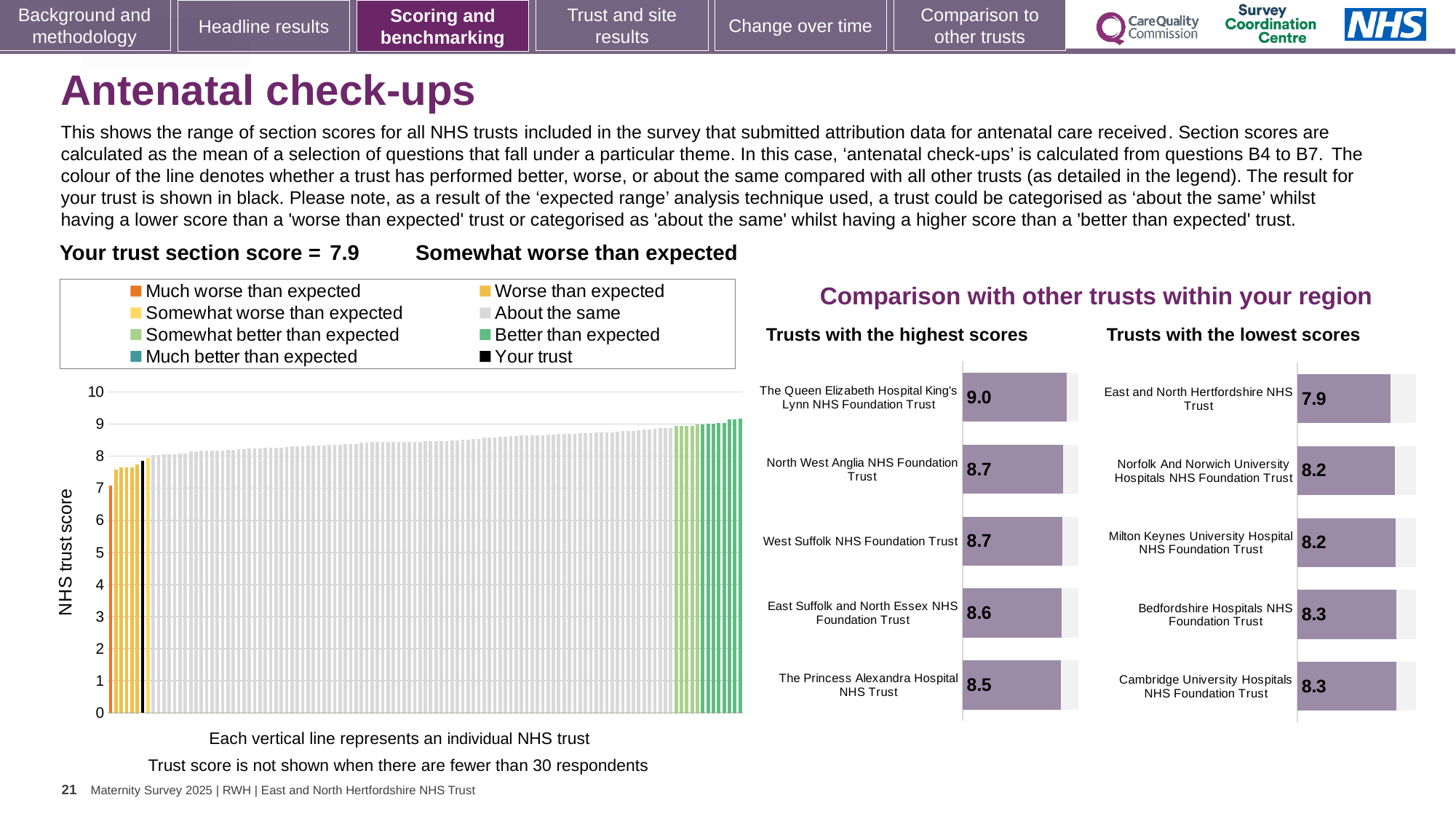
In the 'Trusts with the lowest scores' chart, what is the score for Bedfordshire Hospitals NHS Foundation Trust? 8.3 In the 'Trusts with the highest scores' chart, what is the difference between the scores of The Queen Elizabeth Hospital King's Lynn NHS Foundation Trust and East Suffolk and North Essex NHS Foundation Trust? 0.4 In the 'Trusts with the lowest scores' chart, which trust has the lowest score? East and North Hertfordshire NHS Trust What type of chart is the large chart on the left showing NHS trust scores? Bar chart In the 'Trusts with the highest scores' chart, which trust has the highest score? The Queen Elizabeth Hospital King's Lynn NHS Foundation Trust In the large chart on the left showing NHS trust scores, do the values rise or fall from left to right? Rise Which is larger: the score for West Suffolk NHS Foundation Trust in the highest scores chart or the score for Milton Keynes University Hospital NHS Foundation Trust in the lowest scores chart? West Suffolk NHS Foundation Trust How many trusts are shown in the 'Trusts with the lowest scores' chart? 5 In the 'Trusts with the highest scores' chart, what is the score for The Queen Elizabeth Hospital King's Lynn NHS Foundation Trust? 9.0 How many entries does the legend above the large chart on the left list? 8 In the 'Trusts with the lowest scores' chart, what is the difference between the scores of Cambridge University Hospitals NHS Foundation Trust and East and North Hertfordshire NHS Trust? 0.4 In the 'Trusts with the highest scores' chart, what is the score for The Princess Alexandra Hospital NHS Trust? 8.5